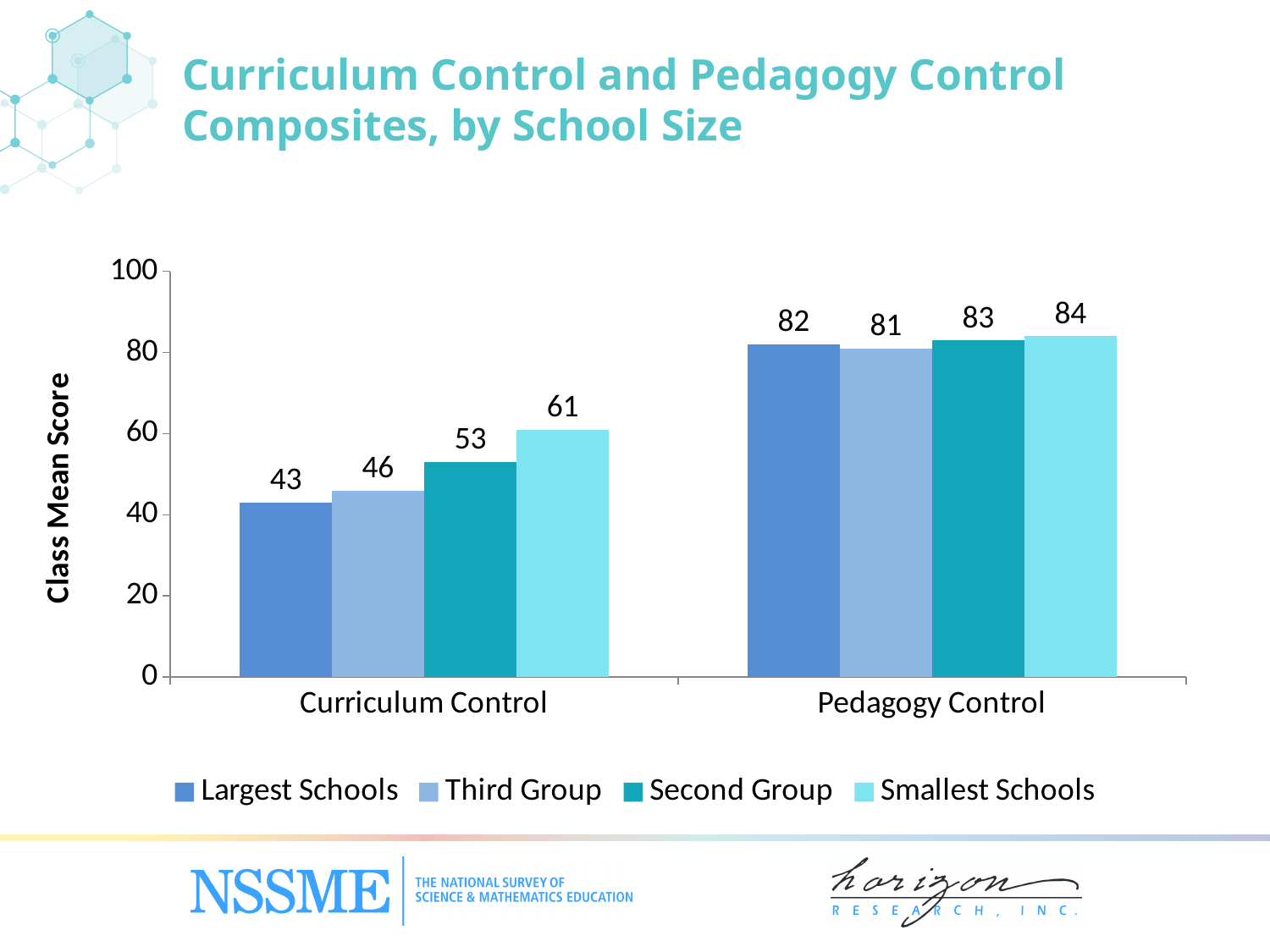
What is the label of the vertical axis? Class Mean Score Which school size group has the lowest Curriculum Control score? Largest Schools How many series does the legend list? 4 What is the class mean score for Largest Schools on Curriculum Control? 43 What is the difference between the Pedagogy Control and Curriculum Control scores for Third Group? 35 What kind of chart is shown on the slide? Bar chart Which is larger for Second Group: the Curriculum Control score or the Pedagogy Control score? Pedagogy Control Which school size group has the highest Curriculum Control score? Smallest Schools What is the class mean score for Second Group on Curriculum Control? 53 Is the Largest Schools score on Pedagogy Control greater or less than 80? greater What is the difference between the Smallest Schools and Largest Schools scores on Curriculum Control? 18 What is the class mean score for Smallest Schools on Pedagogy Control? 84